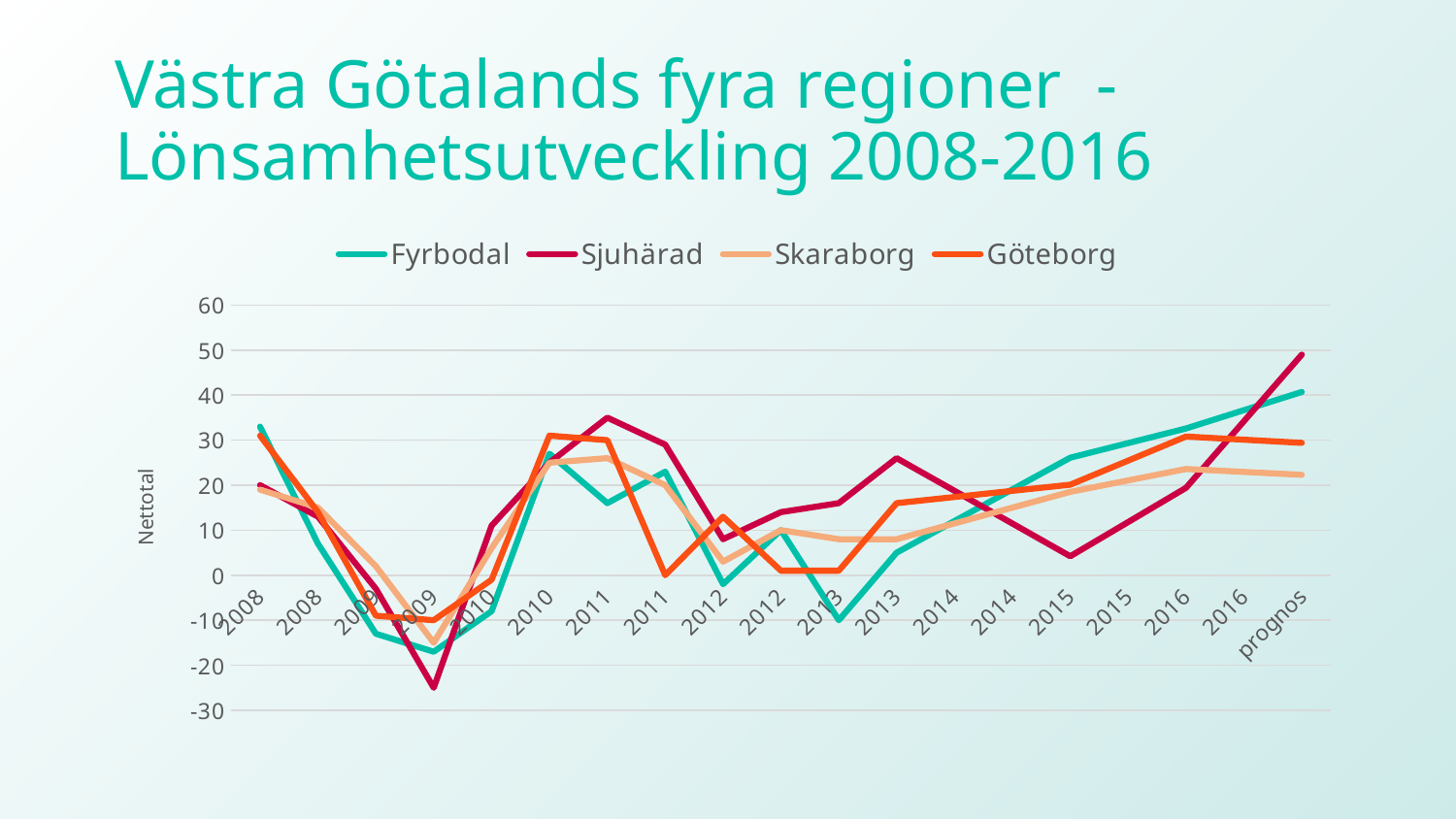
Is the value for Sjuhärad at the first 2015 point greater or less than 10? less Is the lowest value for Sjuhärad (at the second 2009 point) greater or less than -20? less Which series has the lowest value at the second 2009 point? Sjuhärad Is the value for Fyrbodal at the first 2013 point greater or less than 0? less How many points are there along the x axis? 19 Which series has the highest value at 'prognos'? Sjuhärad What kind of chart is shown on the slide? line chart At the first 2013 point, which is larger: Sjuhärad or Fyrbodal? Sjuhärad What is the label on the vertical axis? Nettotal Which series are listed in the legend? Fyrbodal, Sjuhärad, Skaraborg, Göteborg How many series does the legend list? 4